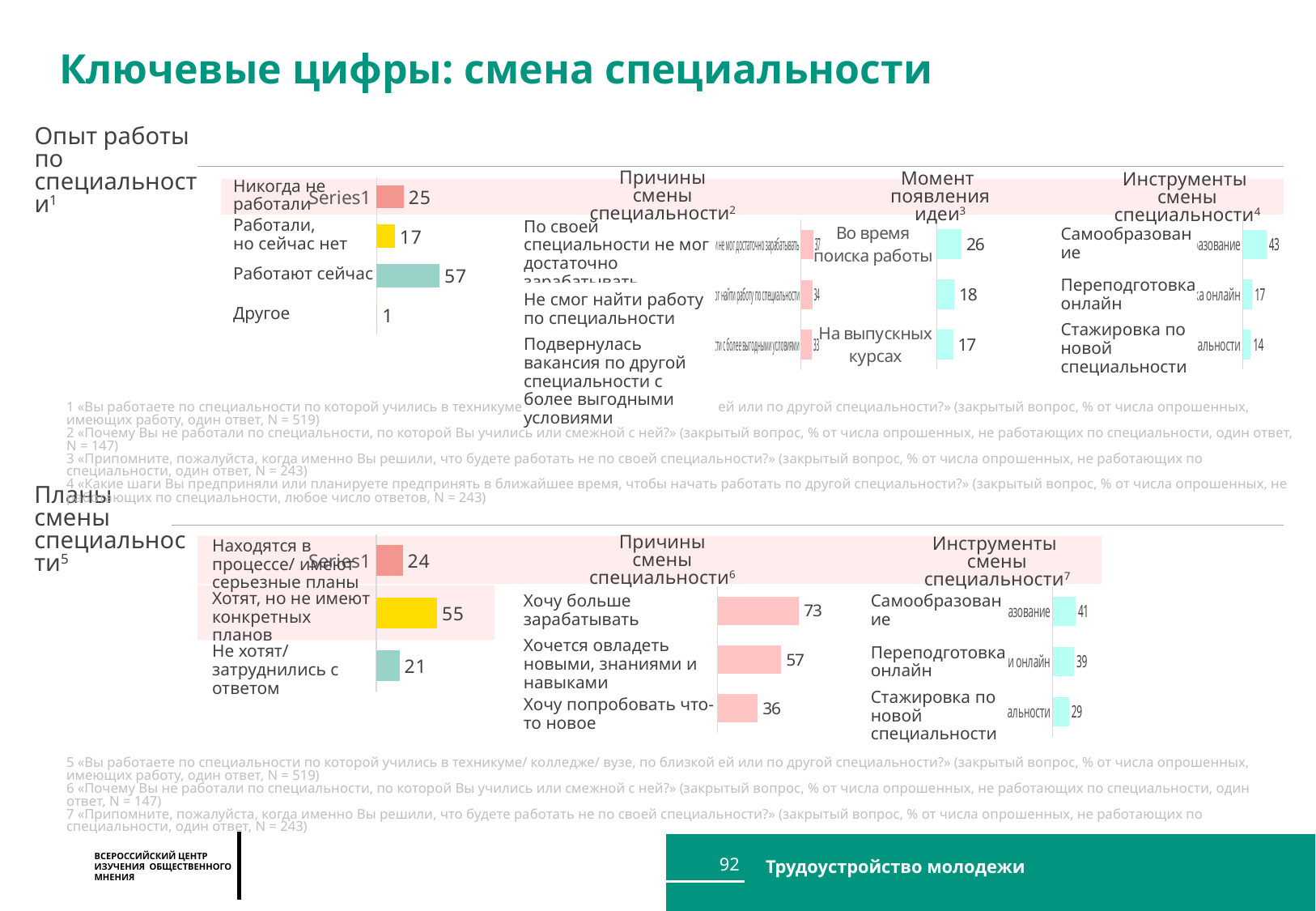
In the top 'Инструменты смены специальности' chart, which category has the highest value? Самообразование In the 'Момент появления идеи' chart, what is the value for 'Во время поиска работы'? 26 In the top 'Причины смены специальности' chart, what is the value for 'Не смог найти работу по специальности'? 34 In the 'Планы смены специальности' chart at the bottom left, which is larger: 'Находятся в процессе/ имеют серьезные планы' or 'Не хотят/ затруднились с ответом'? Находятся в процессе/ имеют серьезные планы In the 'Планы смены специальности' chart at the bottom left, what is the value for 'Хотят, но не имеют конкретных планов'? 55 In the 'Опыт работы по специальности' chart at the top left, what is the difference between 'Никогда не работали' and 'Работали, но сейчас нет'? 8 In the bottom 'Причины смены специальности' chart, what is the difference between 'Хочу больше зарабатывать' and 'Хочу попробовать что-то новое'? 37 In the 'Опыт работы по специальности' chart at the top left, which category has the lowest value? Другое What type of chart is the bottom 'Причины смены специальности' chart? Bar chart In the top 'Инструменты смены специальности' chart, what is the value for 'Стажировка по новой специальности'? 14 In the bottom 'Инструменты смены специальности' chart, how many categories are shown? 3 In the 'Опыт работы по специальности' chart at the top left, what is the value for 'Работают сейчас'? 57